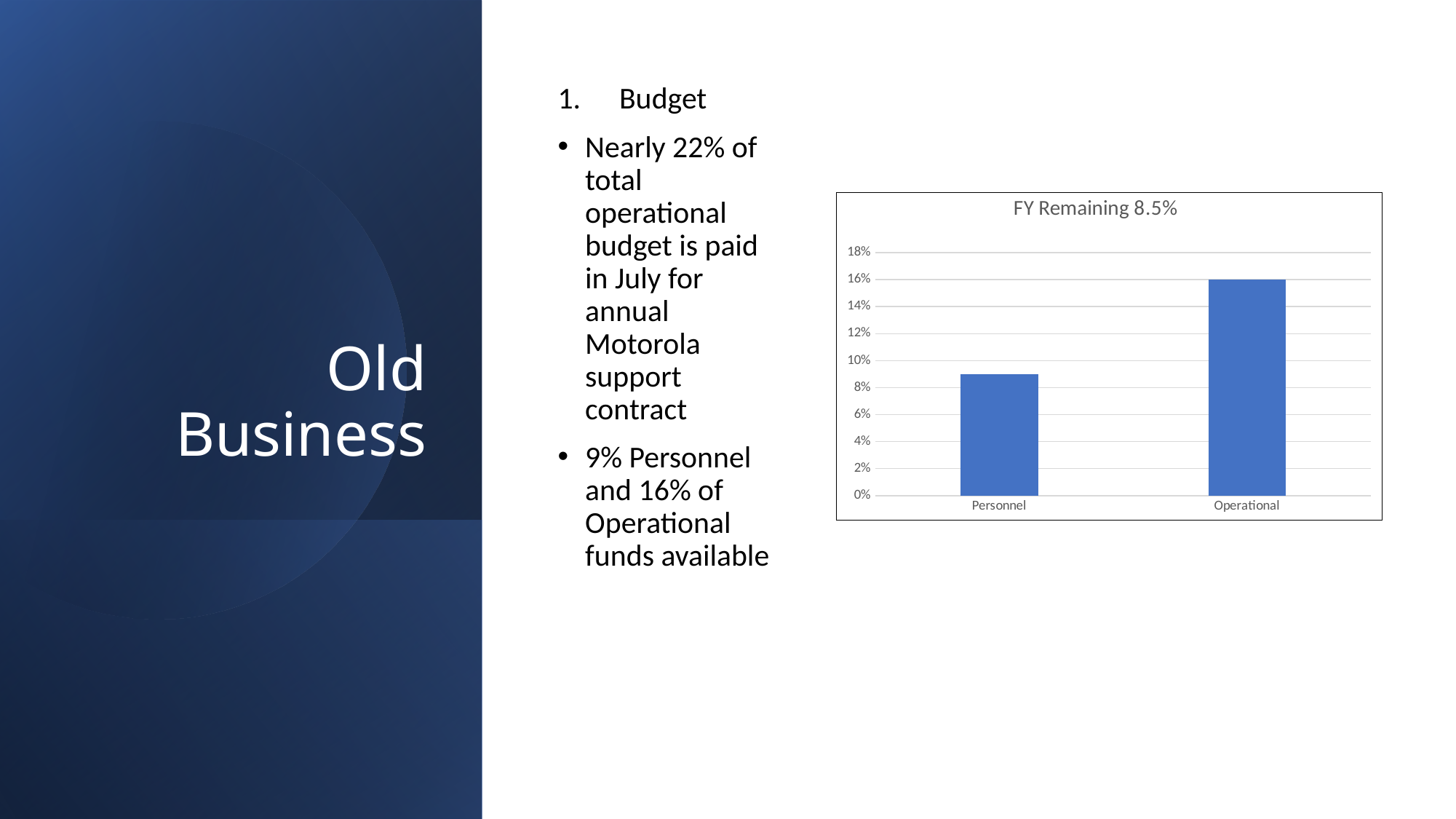
What is the highest value shown on the y axis of the chart? 18% Is the value for Personnel greater or less than 10%? less What is the value for Personnel in the chart? 9% Is the value for Operational greater or less than 14%? greater How many categories are shown on the x axis of the chart? 2 Which category has the lowest value in the chart? Personnel Which is larger, the value for Personnel or the value for Operational? Operational Which category has the highest value in the chart? Operational What is the title of the chart? FY Remaining 8.5% What type of chart is shown on the slide? bar chart What is the difference between the Operational value and the Personnel value? 7% What is the value for Operational in the chart? 16%